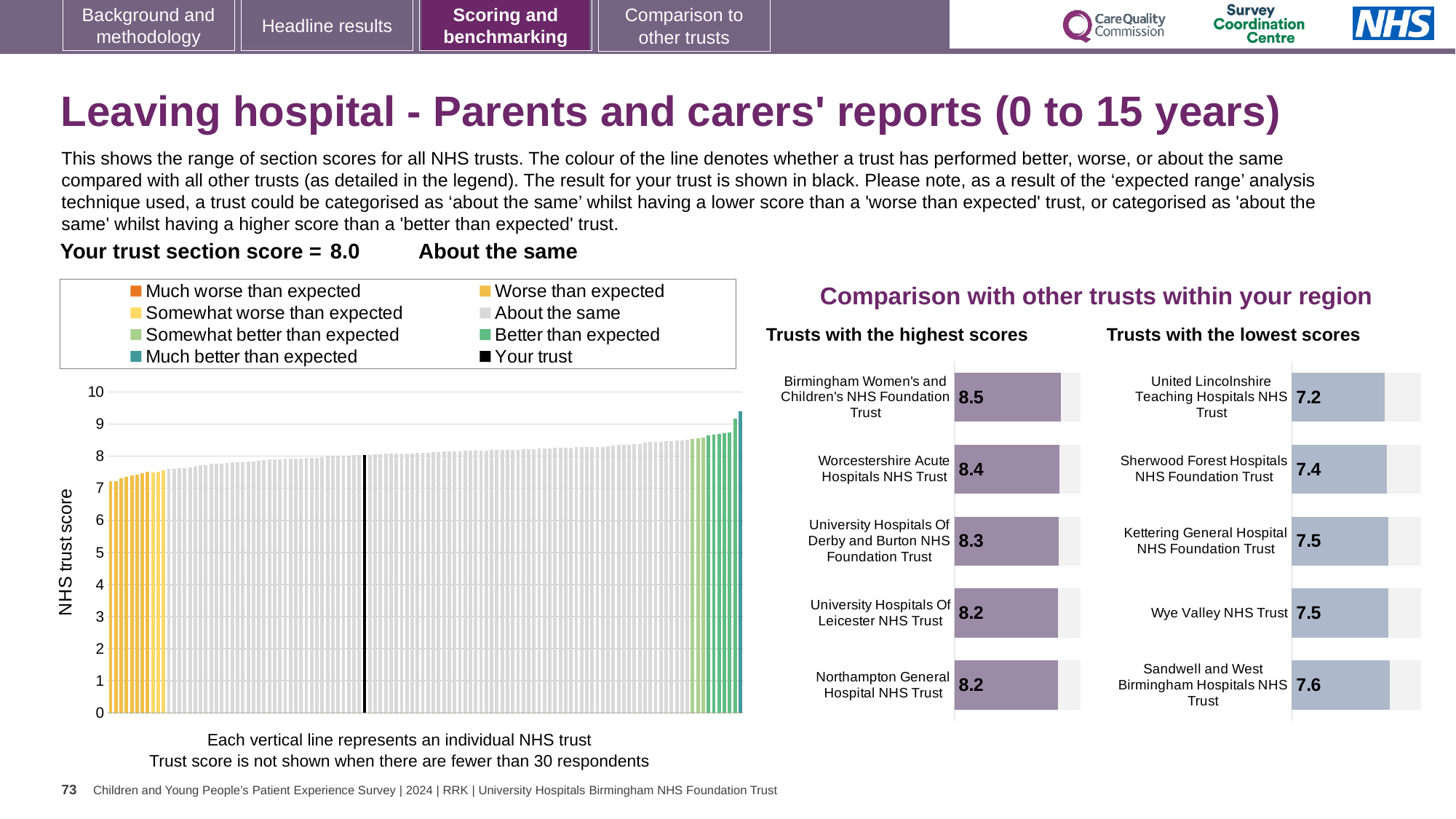
In the 'Trusts with the lowest scores' chart, what is the score for Kettering General Hospital NHS Foundation Trust? 7.5 How many entries does the legend of the large 'NHS trust score' chart list? 8 In the 'Trusts with the highest scores' chart, what is the score for Birmingham Women's and Children's NHS Foundation Trust? 8.5 In the large 'NHS trust score' chart on the left, do the bar values rise or fall from left to right? Rise In the 'Trusts with the lowest scores' chart, which has the larger score: Sherwood Forest Hospitals NHS Foundation Trust or Sandwell and West Birmingham Hospitals NHS Trust? Sandwell and West Birmingham Hospitals NHS Trust How many trusts are shown in the 'Trusts with the highest scores' chart? 5 In the 'Trusts with the lowest scores' chart, which trust has the lowest score? United Lincolnshire Teaching Hospitals NHS Trust What kind of chart is the large 'NHS trust score' chart on the left of the slide? Bar chart In the 'Trusts with the highest scores' chart, which trust has the highest score? Birmingham Women's and Children's NHS Foundation Trust In the large 'NHS trust score' chart on the left, what is the section score for your trust (the black bar)? 8.0 In the 'Trusts with the highest scores' chart, what is the difference between the scores of Birmingham Women's and Children's NHS Foundation Trust and Northampton General Hospital NHS Trust? 0.3 In the 'Trusts with the lowest scores' chart, what is the score for United Lincolnshire Teaching Hospitals NHS Trust? 7.2